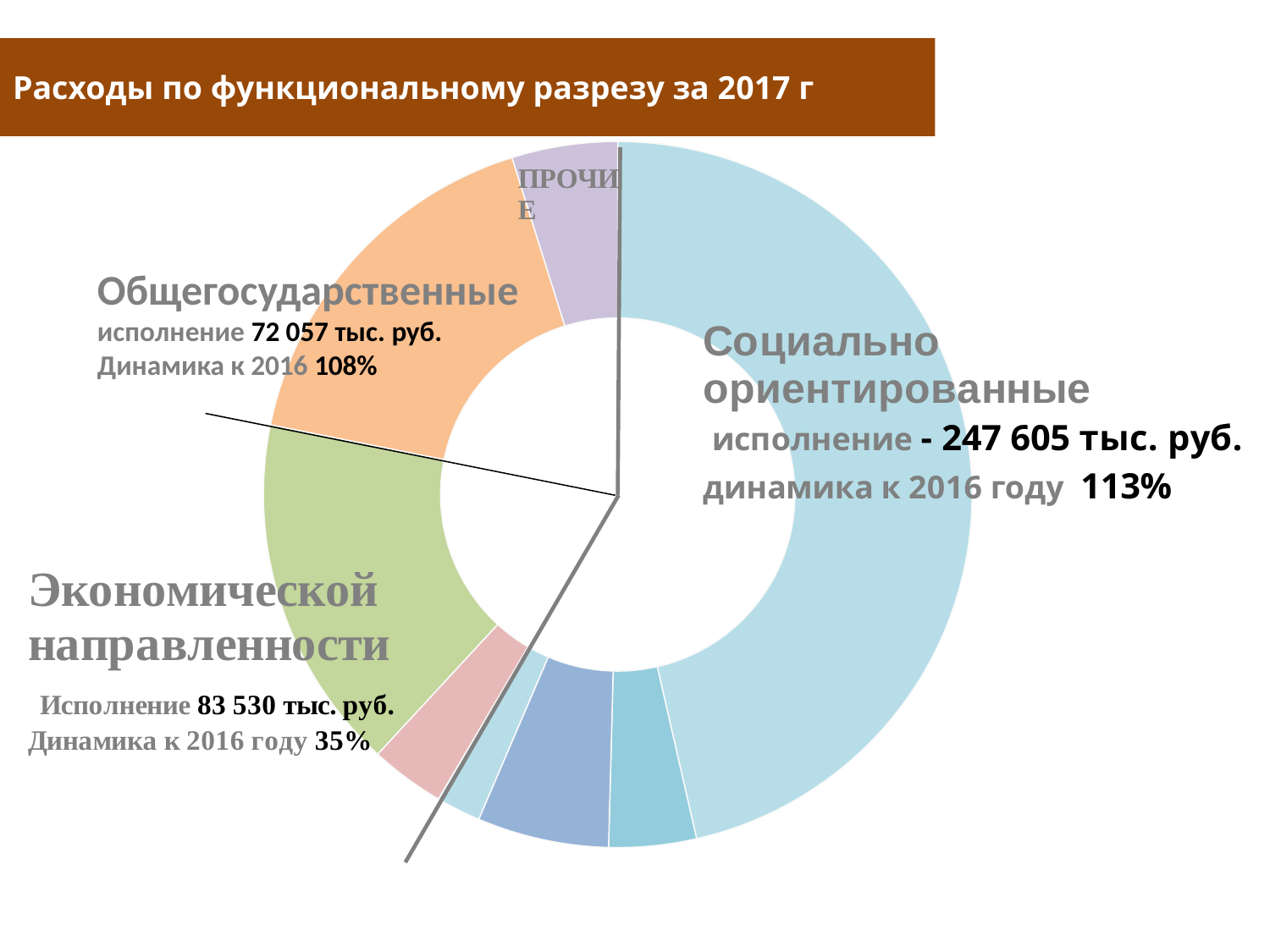
What is the dynamics to 2016 (динамика к 2016 году) for Социально ориентированные? 113% What is the difference in execution value between Экономической направленности and Общегосударственные? 11 473 тыс. руб. What is the execution value (Исполнение) for Экономической направленности? 83 530 тыс. руб. What kind of chart is shown on the slide? Doughnut chart What is the difference in execution value between Социально ориентированные and Общегосударственные? 175 548 тыс. руб. What is the execution value (исполнение) for Общегосударственные? 72 057 тыс. руб. What is the dynamics to 2016 (Динамика к 2016) for Общегосударственные? 108% Which is larger in execution value: Общегосударственные or Экономической направленности? Экономической направленности What is the dynamics to 2016 (Динамика к 2016 году) for Экономической направленности? 35% Which labelled category has the largest execution value? Социально ориентированные What is the execution value (исполнение) for Социально ориентированные? 247 605 тыс. руб. What is the title of the slide's chart? Расходы по функциональному разрезу за 2017 г